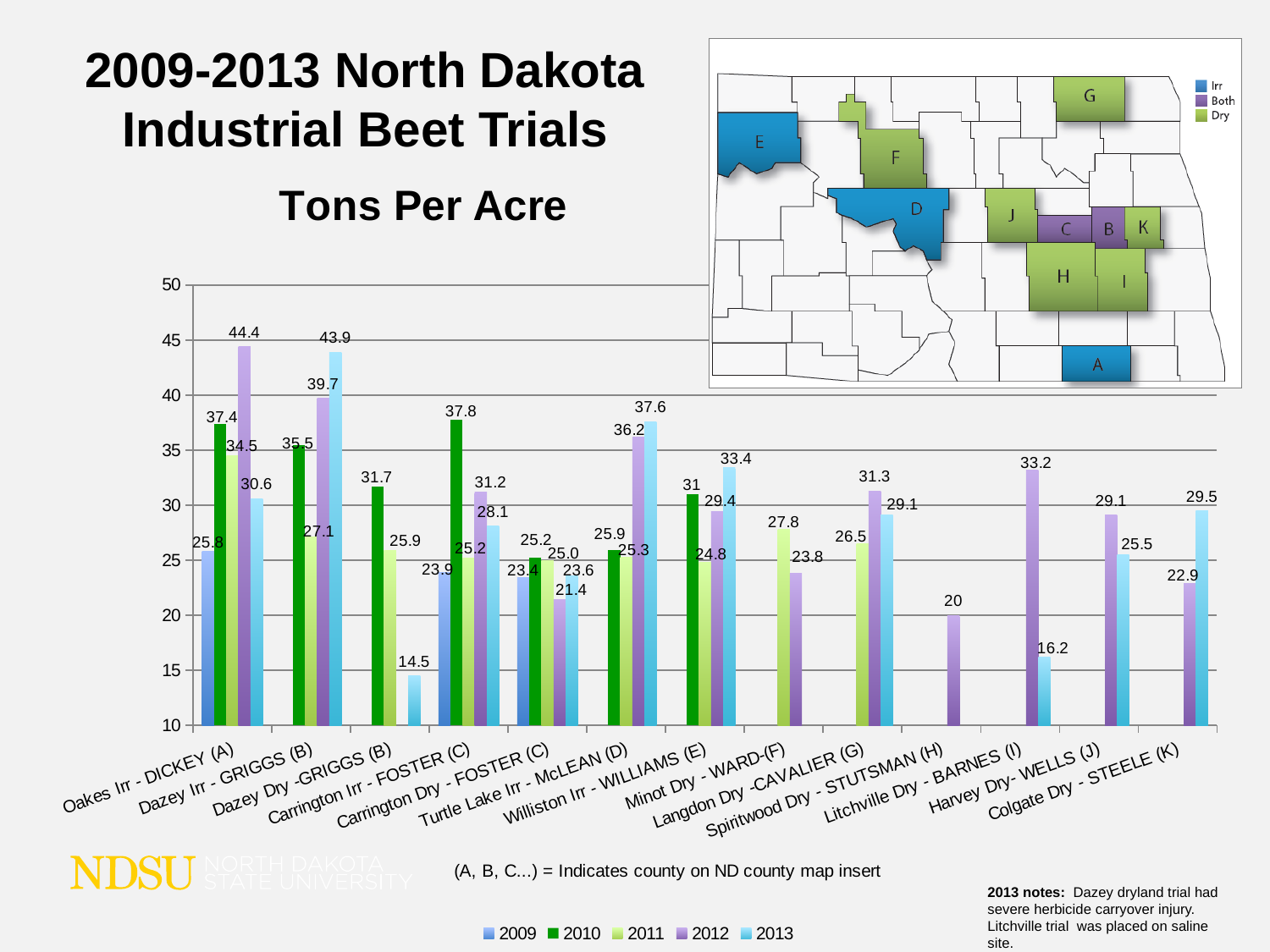
What is the difference between the 2013 and 2012 values for Turtle Lake Irr - McLEAN (D)? 1.4 What was the 2012 tons per acre value for Oakes Irr - DICKEY (A)? 44.4 Which location and year has the highest tons per acre on the chart? Oakes Irr - DICKEY (A), 2012 What was the 2013 tons per acre value for Dazey Dry - GRIGGS (B)? 14.5 How many series does the legend list? 5 How many trial locations (categories) are shown on the x axis? 13 What was the 2012 value for Spiritwood Dry - STUTSMAN (H)? 20 What is the unit of measurement shown in the chart subtitle? Tons Per Acre Is the 2013 value for Dazey Irr - GRIGGS (B) greater or less than 40? greater What kind of chart is shown on the slide? bar chart Which is larger for Litchville Dry - BARNES (I): the 2012 value or the 2013 value? 2012 Which location and year has the lowest tons per acre on the chart? Dazey Dry - GRIGGS (B), 2013